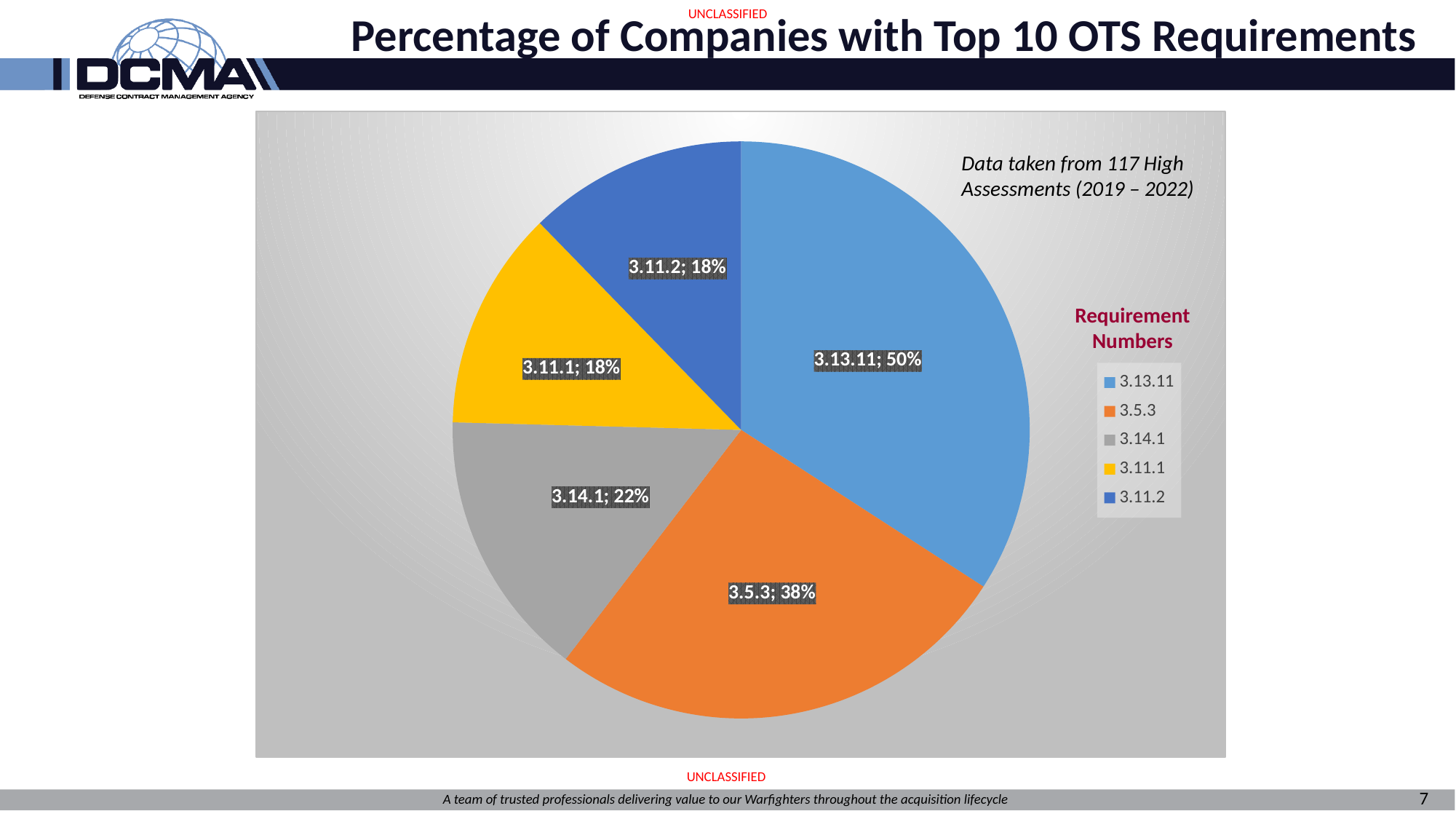
What is the title of the legend? Requirement Numbers Which requirement number has the highest percentage? 3.13.11 What type of chart is shown on the slide? pie chart What is the difference in percentage points between 3.13.11 and 3.5.3? 12 What percentage is shown for requirement 3.5.3? 38% What percentage is shown for requirement 3.13.11? 50% What percentage is shown for requirement 3.14.1? 22% What percentage is shown for requirement 3.11.1? 18% What colour is the slice for requirement 3.11.1? yellow How many requirement numbers are shown in the pie chart? 5 Which has a larger percentage, 3.14.1 or 3.11.2? 3.14.1 What is the difference in percentage points between 3.5.3 and 3.14.1? 16